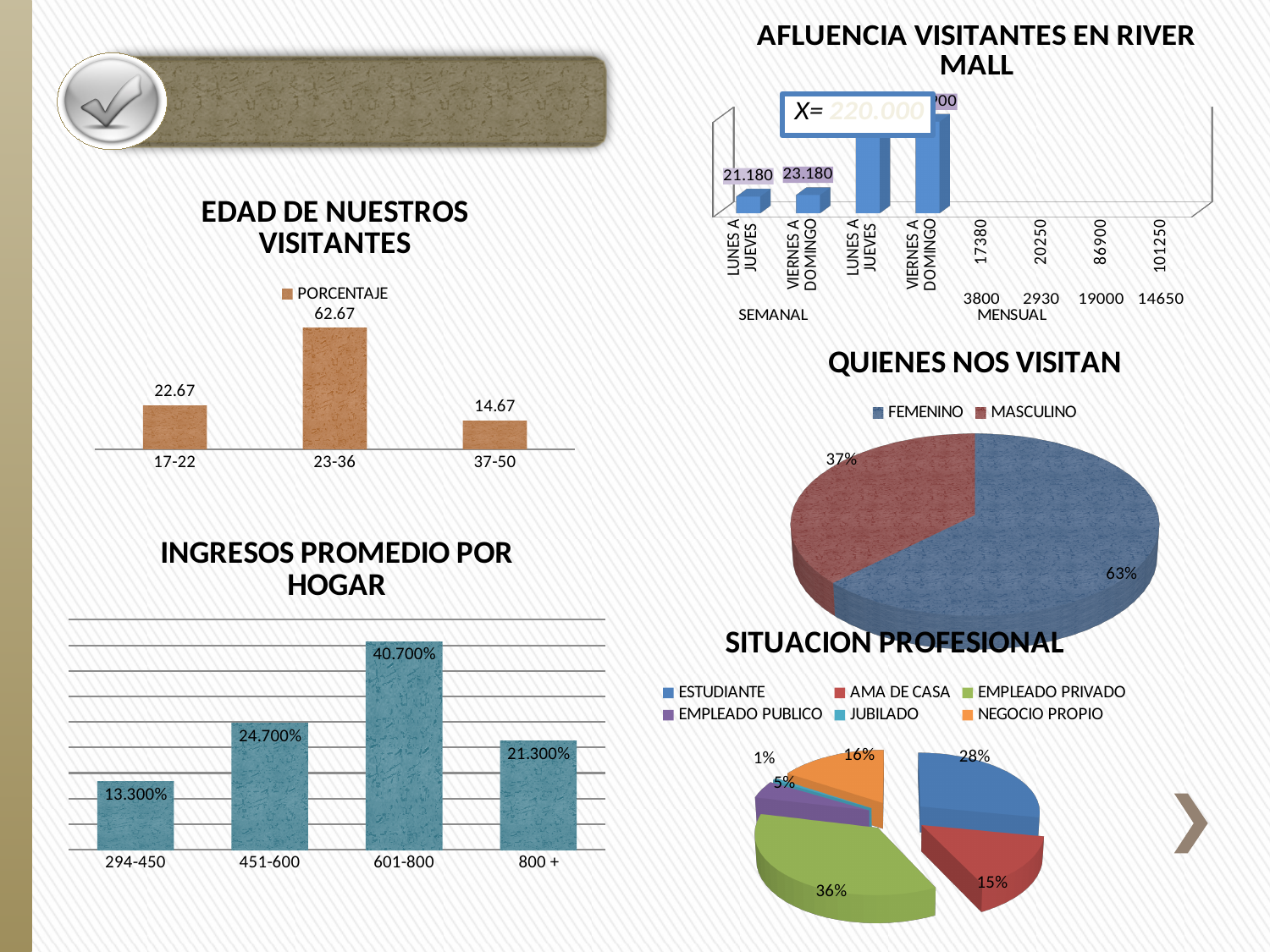
In the 'INGRESOS PROMEDIO POR HOGAR' chart, which is larger, the value for 451-600 or the value for 800 +? 451-600 In the 'INGRESOS PROMEDIO POR HOGAR' chart, which category has the highest value? 601-800 In the 'EDAD DE NUESTROS VISITANTES' chart, what is the value for the 23-36 age group? 62.67 In the 'QUIENES NOS VISITAN' pie chart, what share is FEMENINO? 63% In the 'SITUACION PROFESIONAL' pie chart, which category has the smallest share? JUBILADO In the 'SITUACION PROFESIONAL' pie chart, what share is EMPLEADO PRIVADO? 36% What kind of chart is 'INGRESOS PROMEDIO POR HOGAR'? bar chart In the 'EDAD DE NUESTROS VISITANTES' chart, what is the difference between the values for 17-22 and 37-50? 8 How many series does the legend of the 'SITUACION PROFESIONAL' chart list? 6 How many categories are shown in the 'EDAD DE NUESTROS VISITANTES' chart? 3 In the 'EDAD DE NUESTROS VISITANTES' chart, which age group has the lowest value? 37-50 In the 'INGRESOS PROMEDIO POR HOGAR' chart, what is the value for the 601-800 category? 40.700%